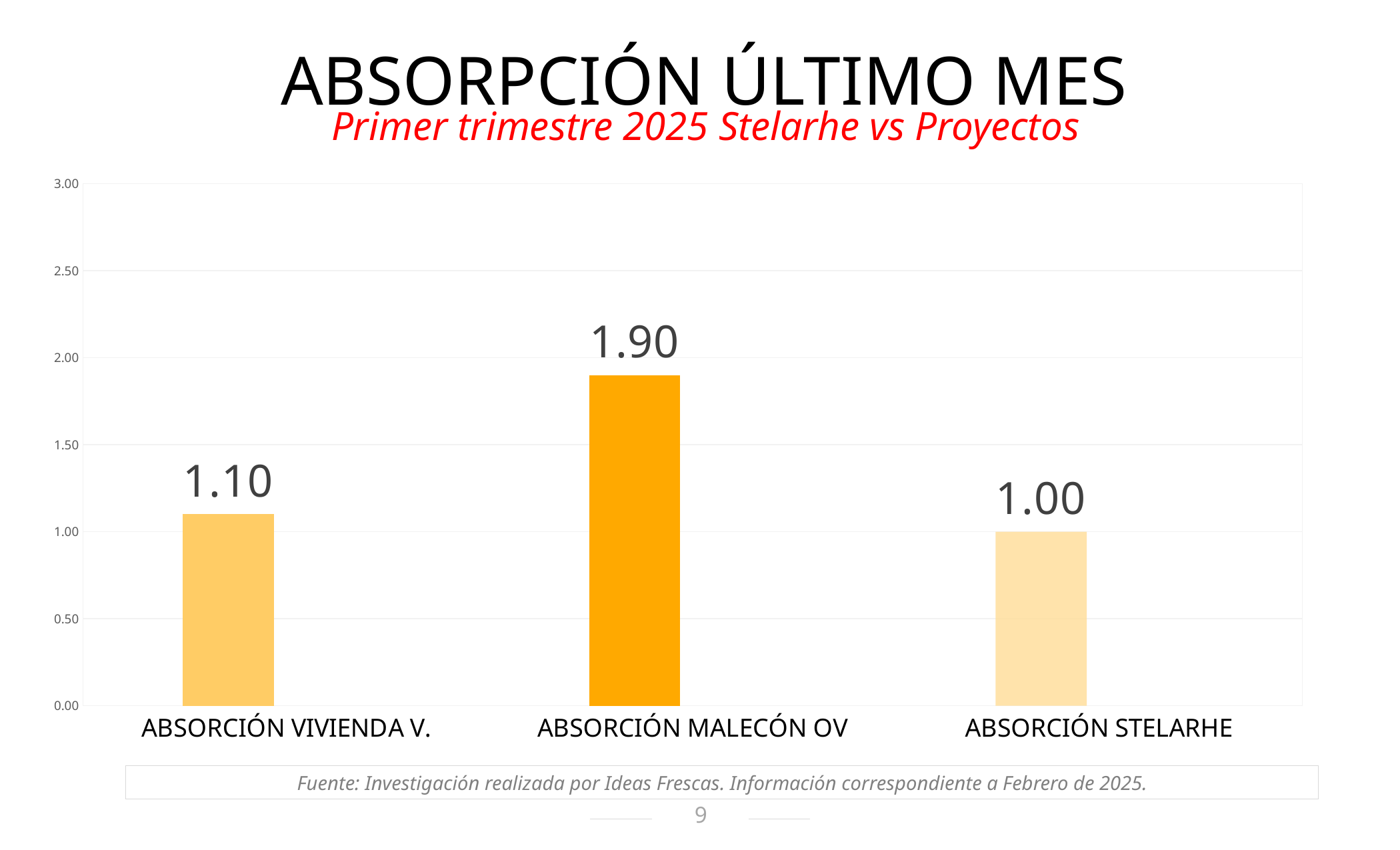
What kind of chart is shown on the slide? bar chart What is the title of the chart? ABSORPCIÓN ÚLTIMO MES What is the value for ABSORCIÓN MALECÓN OV? 1.90 What is the value for ABSORCIÓN VIVIENDA V.? 1.10 Which category has the highest value? ABSORCIÓN MALECÓN OV Is the value for ABSORCIÓN MALECÓN OV greater or less than 1.50? greater Which is larger, the value for ABSORCIÓN VIVIENDA V. or ABSORCIÓN MALECÓN OV? ABSORCIÓN MALECÓN OV How many categories are shown in the chart? 3 What is the value for ABSORCIÓN STELARHE? 1.00 Which category has the lowest value? ABSORCIÓN STELARHE What is the difference between the values for ABSORCIÓN VIVIENDA V. and ABSORCIÓN STELARHE? 0.10 What is the difference between the values for ABSORCIÓN MALECÓN OV and ABSORCIÓN STELARHE? 0.90